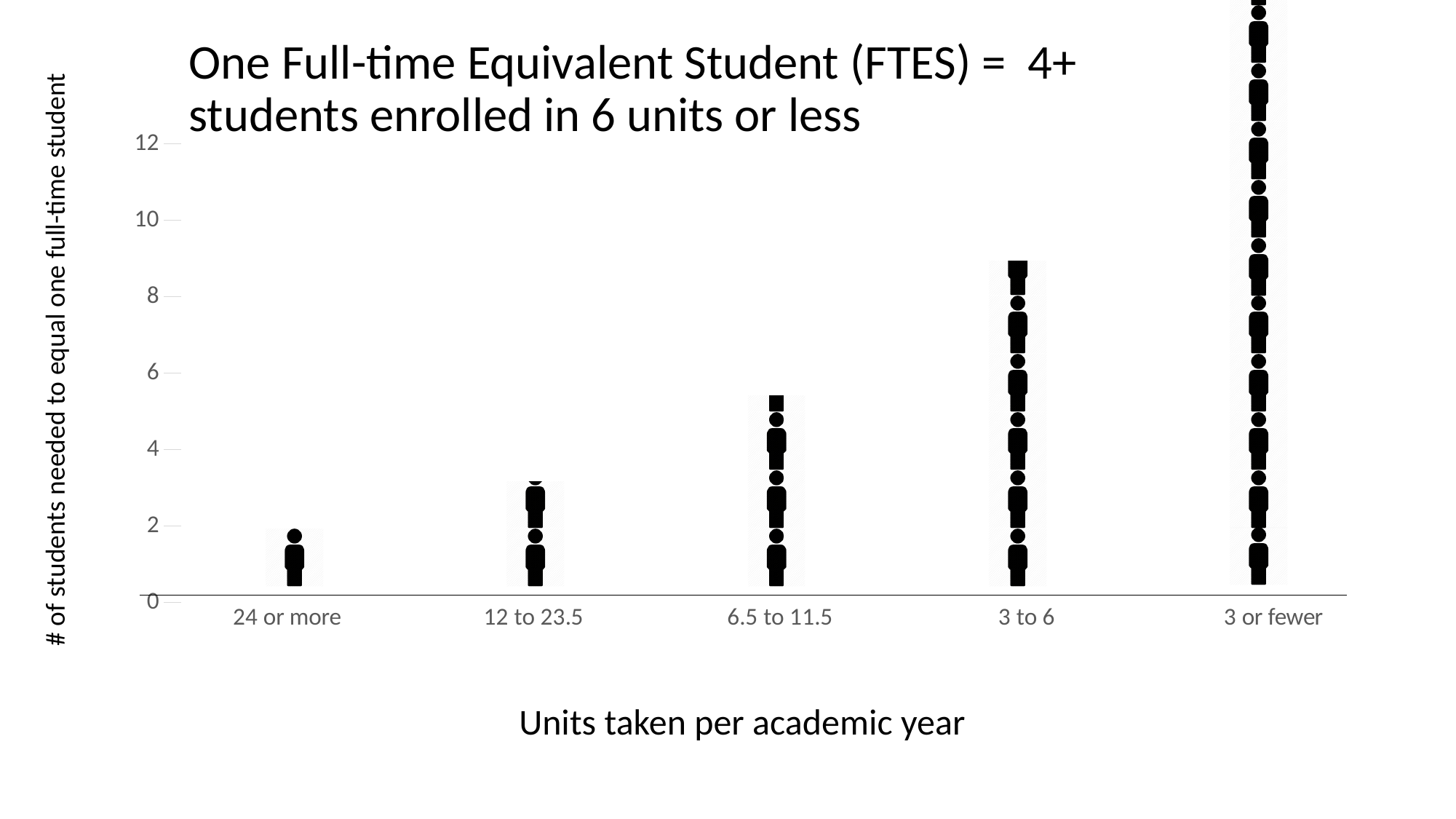
Which is larger, the value for '6.5 to 11.5' or the value for '12 to 23.5'? 6.5 to 11.5 Is the value for '3 or fewer' greater or less than 12? greater Is the value for '3 to 6' greater or less than 8? greater What kind of chart is shown on the slide? bar chart Is the value for '12 to 23.5' greater or less than 4? less How many categories are shown along the x axis? 5 What is the label of the x axis? Units taken per academic year Do the values rise or fall moving from left to right along the x axis? rise Which category has the highest number of students needed to equal one full-time student? 3 or fewer Which category has the lowest number of students needed to equal one full-time student? 24 or more